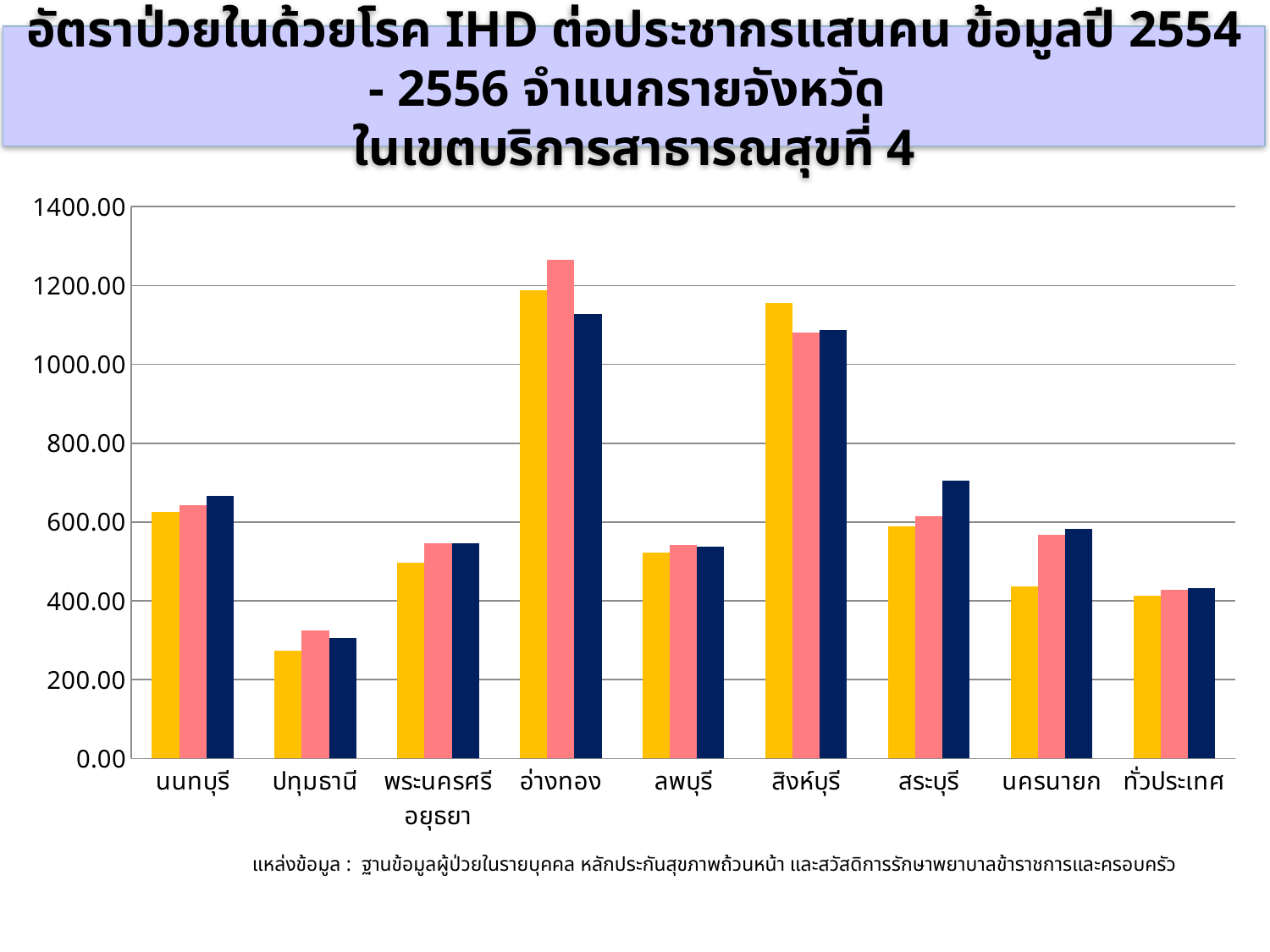
Is the dark blue bar for สระบุรี greater or less than 600.00? greater Is the dark blue bar for ปทุมธานี greater or less than 400.00? less How many bars are plotted for each province in the chart? 3 What kind of chart is shown on the slide? bar chart Is the pink bar for ทั่วประเทศ greater or less than 600.00? less What is the highest value shown on the y axis of the chart? 1400.00 Which is larger, the yellow bar for ปทุมธานี or the yellow bar for นครนายก? นครนายก How many categories are shown along the x axis of the chart? 9 Which province has the shortest bars in the chart? ปทุมธานี Which province has the tallest bars in the chart? อ่างทอง Which is larger, the pink bar for อ่างทอง or the pink bar for สิงห์บุรี? อ่างทอง